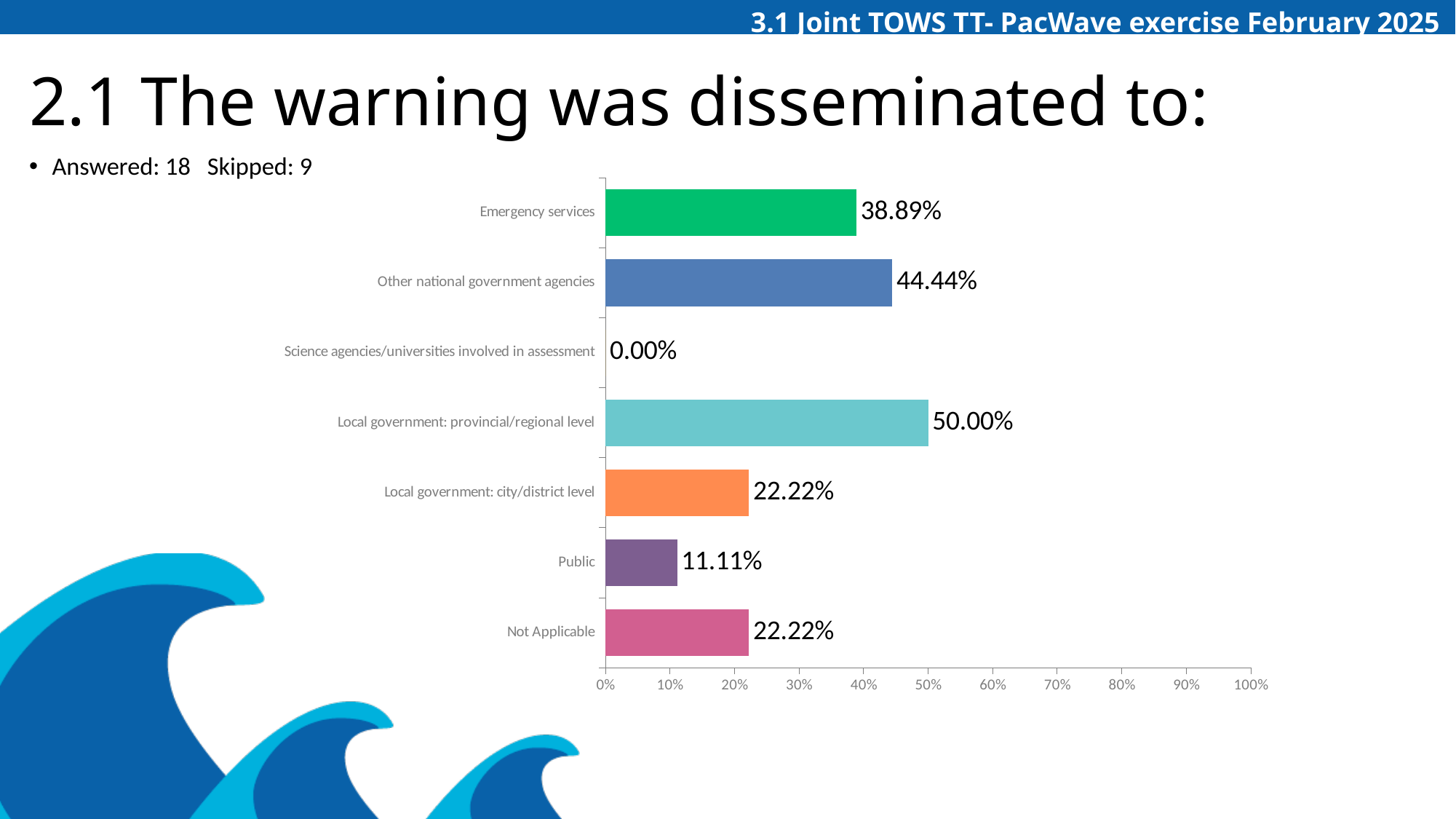
Which category has the highest percentage? Local government: provincial/regional level What is the title of the slide containing the chart? 2.1 The warning was disseminated to: Is the value for Not Applicable greater or less than 30%? less What percentage is shown for Public? 11.11% Which is larger, the value for Emergency services or the value for Other national government agencies? Other national government agencies What percentage is shown for Emergency services? 38.89% How many categories are shown in the chart? 7 What kind of chart is shown on the slide? bar chart What is the difference between the percentages for Local government: provincial/regional level and Local government: city/district level? 27.78% What percentage is shown for Other national government agencies? 44.44% Which category has the lowest percentage? Science agencies/universities involved in assessment What percentage is shown for Science agencies/universities involved in assessment? 0.00%